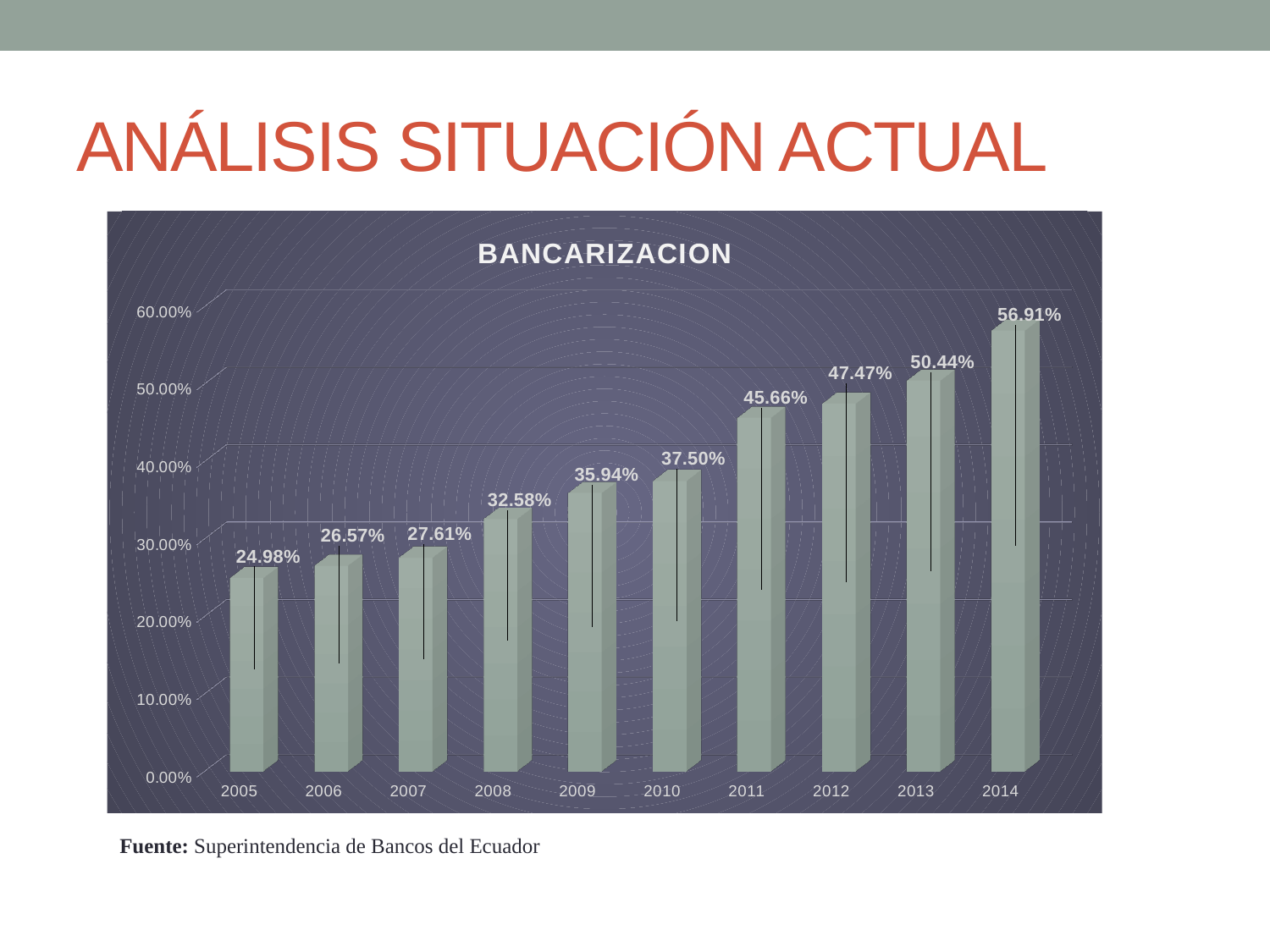
Which is larger in the BANCARIZACION chart, the value for 2009 or the value for 2013? 2013 Is the value for 2010 in the BANCARIZACION chart greater or less than 40.00%? less What is the value for 2008 in the BANCARIZACION chart? 32.58% What is the title of the chart on the slide? BANCARIZACION How many years are shown in the BANCARIZACION chart? 10 What is the value for 2012 in the BANCARIZACION chart? 47.47% Do the values in the BANCARIZACION chart rise or fall from 2005 to 2014? rise Which year has the highest value in the BANCARIZACION chart? 2014 What is the difference between the values for 2011 and 2010 in the BANCARIZACION chart? 8.16% What is the difference between the values for 2014 and 2005 in the BANCARIZACION chart? 31.93% Which year has the lowest value in the BANCARIZACION chart? 2005 What kind of chart is the BANCARIZACION chart? bar chart